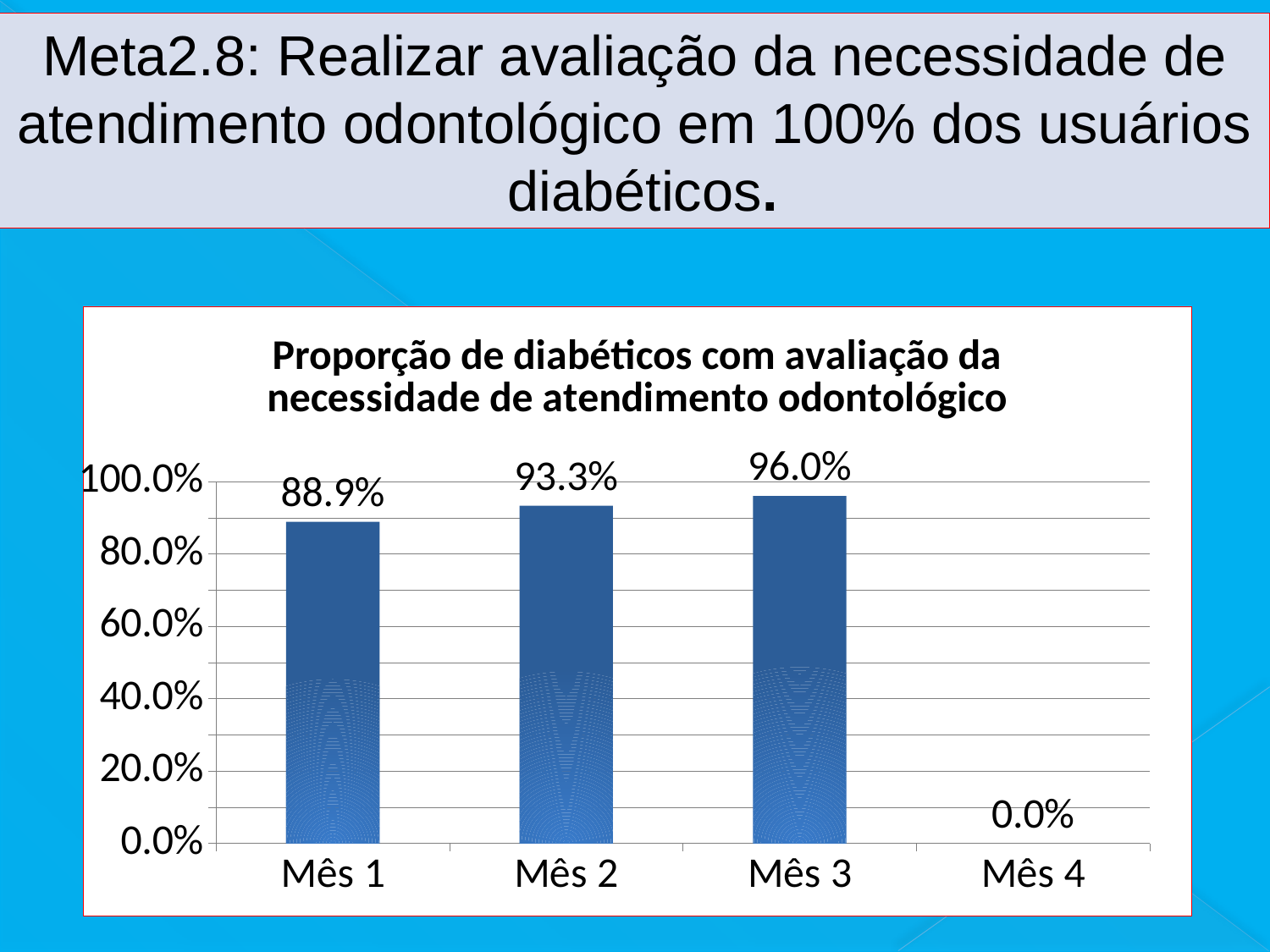
What is the title of the chart? Proporção de diabéticos com avaliação da necessidade de atendimento odontológico What is the value for Mês 1? 88.9% What kind of chart is shown? bar chart What is the value for Mês 2? 93.3% What is the value for Mês 4? 0.0% Which month has the highest value? Mês 3 Is the value for Mês 2 greater or less than 80.0%? greater Which month has the lowest value? Mês 4 How many months are shown on the x axis? 4 What is the value for Mês 3? 96.0% Which is larger, the value for Mês 2 or the value for Mês 1? Mês 2 What is the difference between the values for Mês 3 and Mês 1? 7.1%